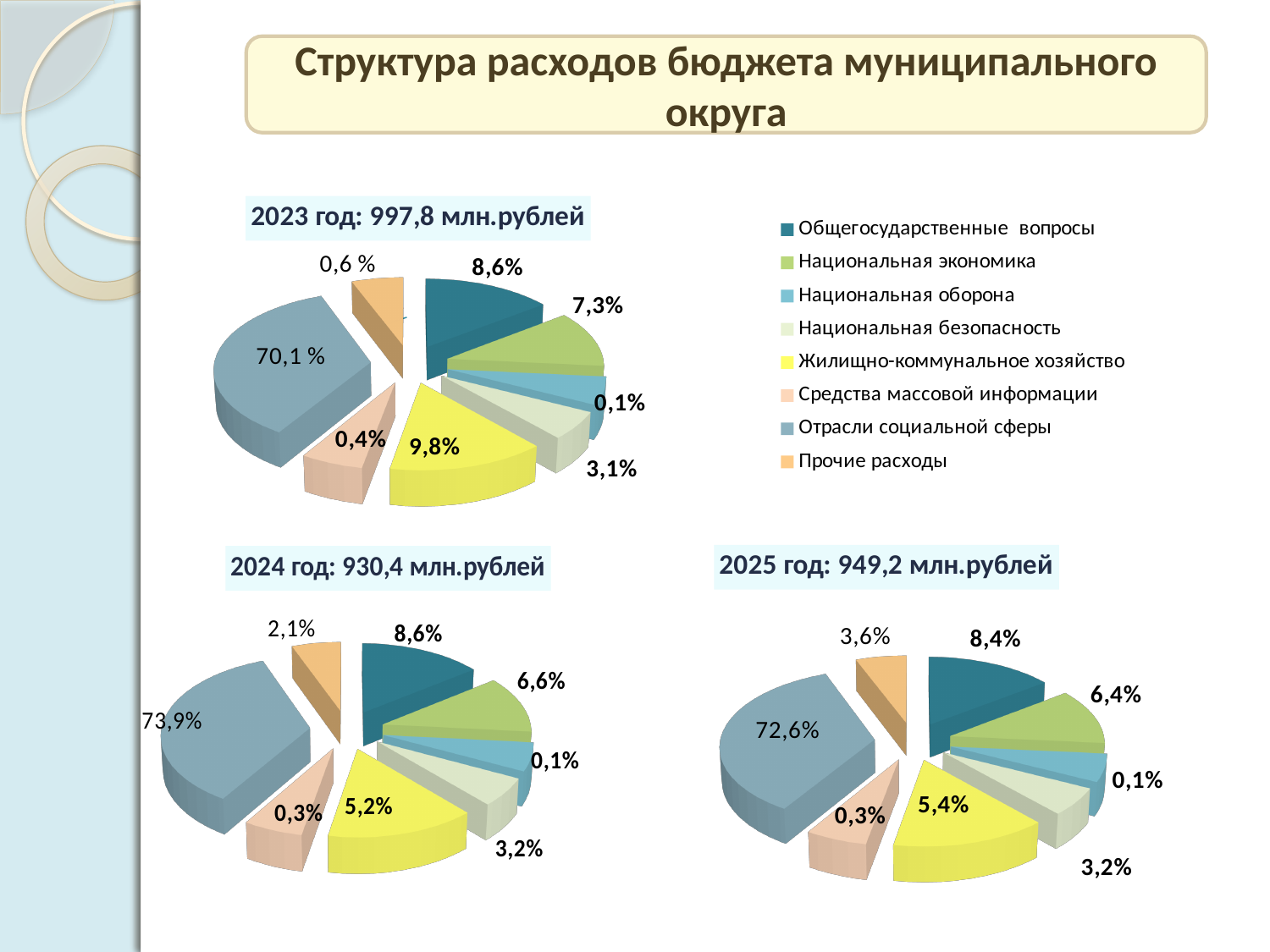
In the 2023 год: 997,8 млн.рублей chart, which category has the smallest share? Национальная оборона In the 2023 год: 997,8 млн.рублей chart, what share is labelled for Отрасли социальной сферы? 70,1 % What kind of chart is used for the 2023 год: 997,8 млн.рублей chart? pie chart In the 2023 год: 997,8 млн.рублей chart, what share is labelled for Жилищно-коммунальное хозяйство? 9,8% In the 2025 год: 949,2 млн.рублей chart, what share is labelled for Прочие расходы? 3,6% In the 2024 год: 930,4 млн.рублей chart, which category has the largest share? Отрасли социальной сферы How many categories does the legend list? 8 In the 2024 год: 930,4 млн.рублей chart, what share is labelled for Отрасли социальной сферы? 73,9% In the 2024 год: 930,4 млн.рублей chart, which is larger: the share for Национальная экономика or the share for Жилищно-коммунальное хозяйство? Национальная экономика In the 2025 год: 949,2 млн.рублей chart, what is the difference between the shares for Общегосударственные вопросы and Национальная экономика? 2,0% How many pie charts are shown on the slide? 3 In the 2025 год: 949,2 млн.рублей chart, what share is labelled for Общегосударственные вопросы? 8,4%